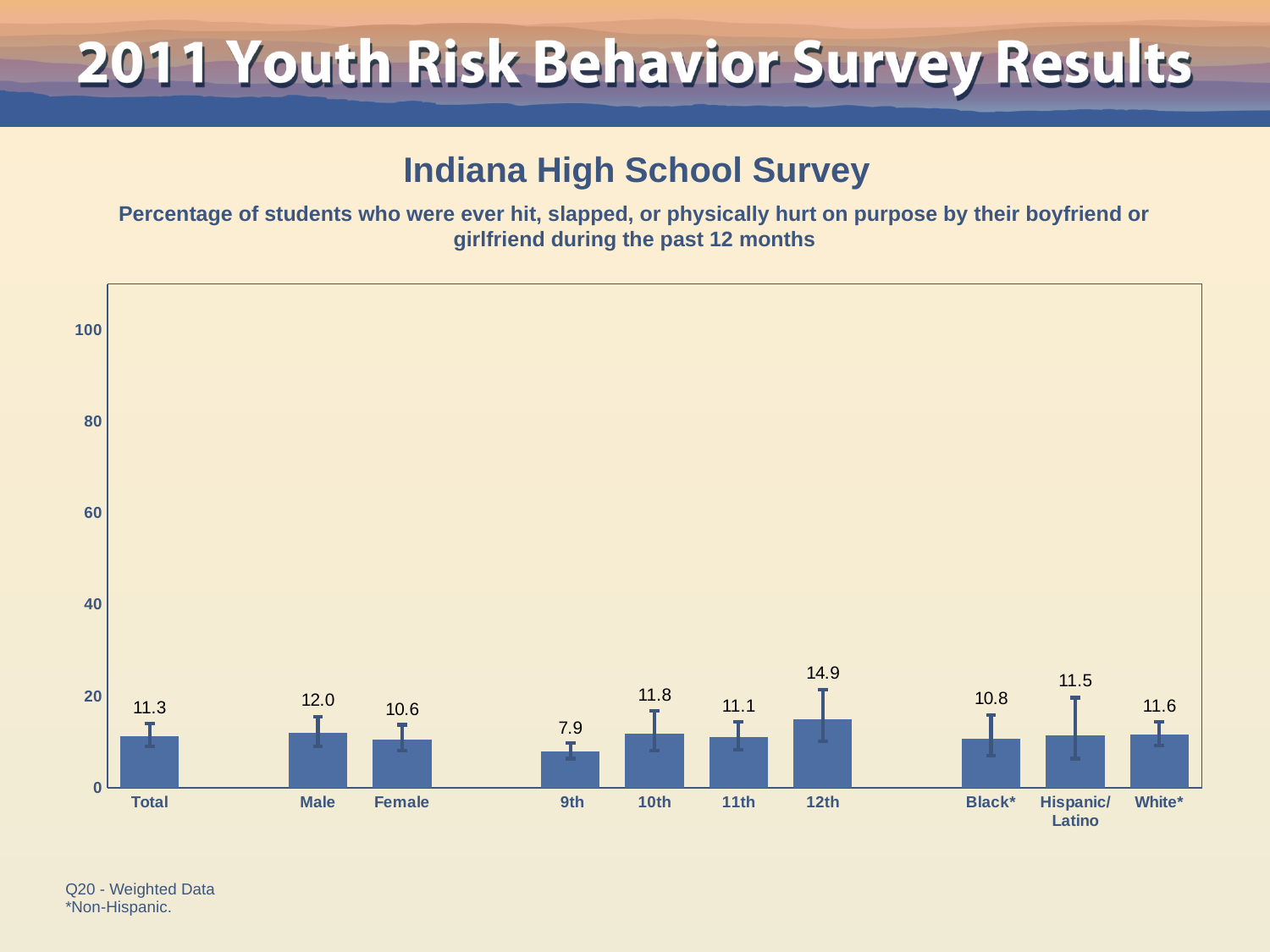
What is the difference between the values for Male and Female? 1.4 What is the maximum value shown on the y axis? 100 What kind of chart is this? bar chart What is the value for 12th grade students? 14.9 What is the value for Total? 11.3 What is the value for Hispanic/Latino students? 11.5 How many categories are shown on the x axis? 10 Which is larger, the value for Black* or the value for White*? White* Which category has the highest value? 12th What is the difference between the values for 12th and 9th grade? 7.0 Is the value for 12th grade greater or less than 20? less Which category has the lowest value? 9th